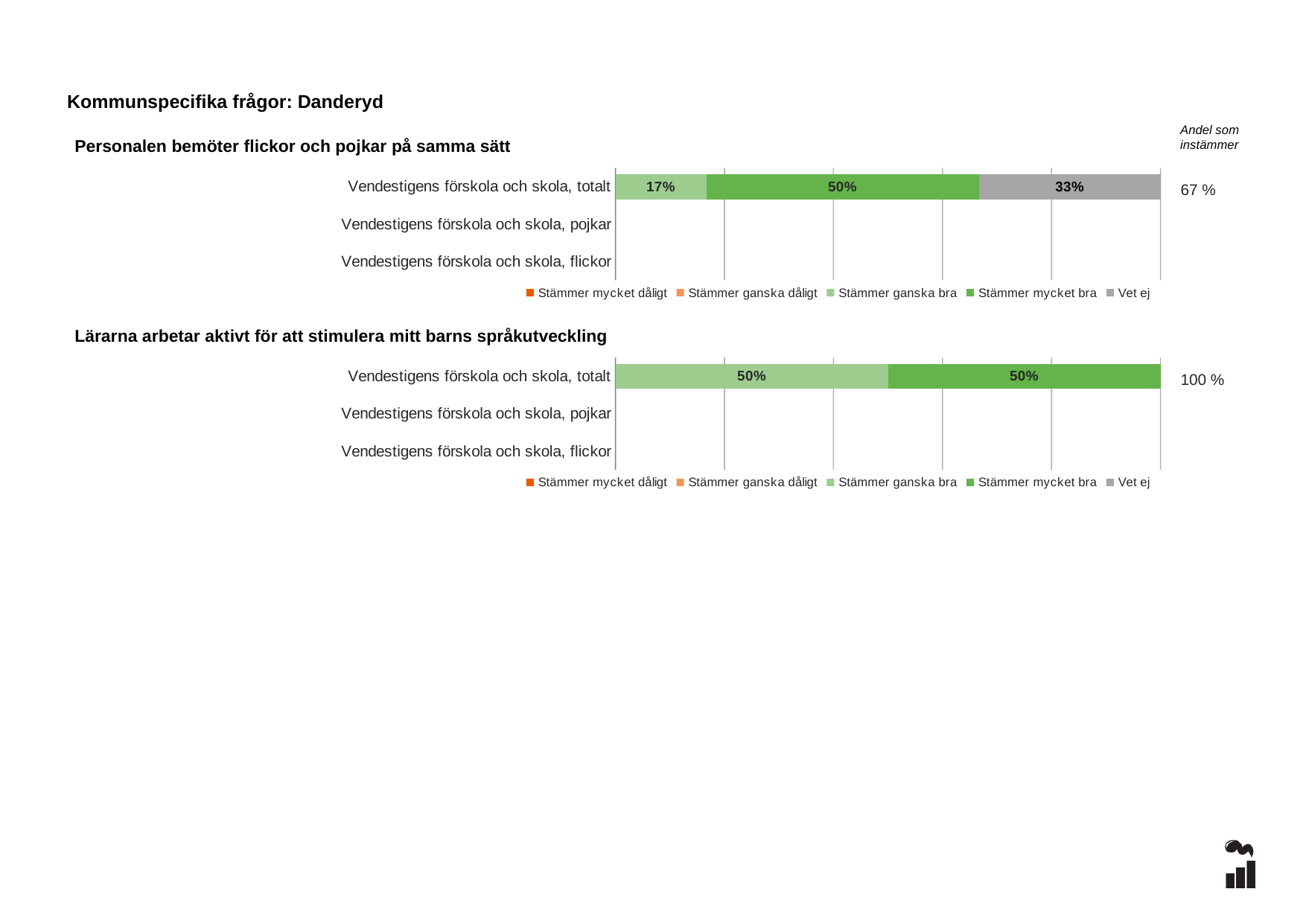
In the chart 'Personalen bemöter flickor och pojkar på samma sätt', what is the difference between the 'Stämmer mycket bra' and 'Vet ej' segments of the 'Vendestigens förskola och skola, totalt' bar? 17% In the chart 'Personalen bemöter flickor och pojkar på samma sätt', which labelled segment of the 'Vendestigens förskola och skola, totalt' bar is the smallest? Stämmer ganska bra In the chart 'Personalen bemöter flickor och pojkar på samma sätt', which is larger for 'Vendestigens förskola och skola, totalt': 'Vet ej' or 'Stämmer ganska bra'? Vet ej In the chart 'Personalen bemöter flickor och pojkar på samma sätt', which segment of the 'Vendestigens förskola och skola, totalt' bar is the largest? Stämmer mycket bra How many series does the legend of the chart 'Lärarna arbetar aktivt för att stimulera mitt barns språkutveckling' list? 5 What kind of chart is 'Personalen bemöter flickor och pojkar på samma sätt'? Stacked bar chart In the chart 'Personalen bemöter flickor och pojkar på samma sätt', what percentage of the 'Vendestigens förskola och skola, totalt' bar is 'Stämmer ganska bra'? 17% In the chart 'Lärarna arbetar aktivt för att stimulera mitt barns språkutveckling', what is the 'Andel som instämmer' value shown for 'Vendestigens förskola och skola, totalt'? 100 % In the chart 'Personalen bemöter flickor och pojkar på samma sätt', what is the 'Andel som instämmer' value shown for 'Vendestigens förskola och skola, totalt'? 67 % In the chart 'Personalen bemöter flickor och pojkar på samma sätt', what percentage of the 'Vendestigens förskola och skola, totalt' bar is 'Stämmer mycket bra'? 50% In the chart 'Personalen bemöter flickor och pojkar på samma sätt', what percentage of the 'Vendestigens förskola och skola, totalt' bar is 'Vet ej'? 33% In the chart 'Lärarna arbetar aktivt för att stimulera mitt barns språkutveckling', what percentage of the 'Vendestigens förskola och skola, totalt' bar is 'Stämmer ganska bra'? 50%